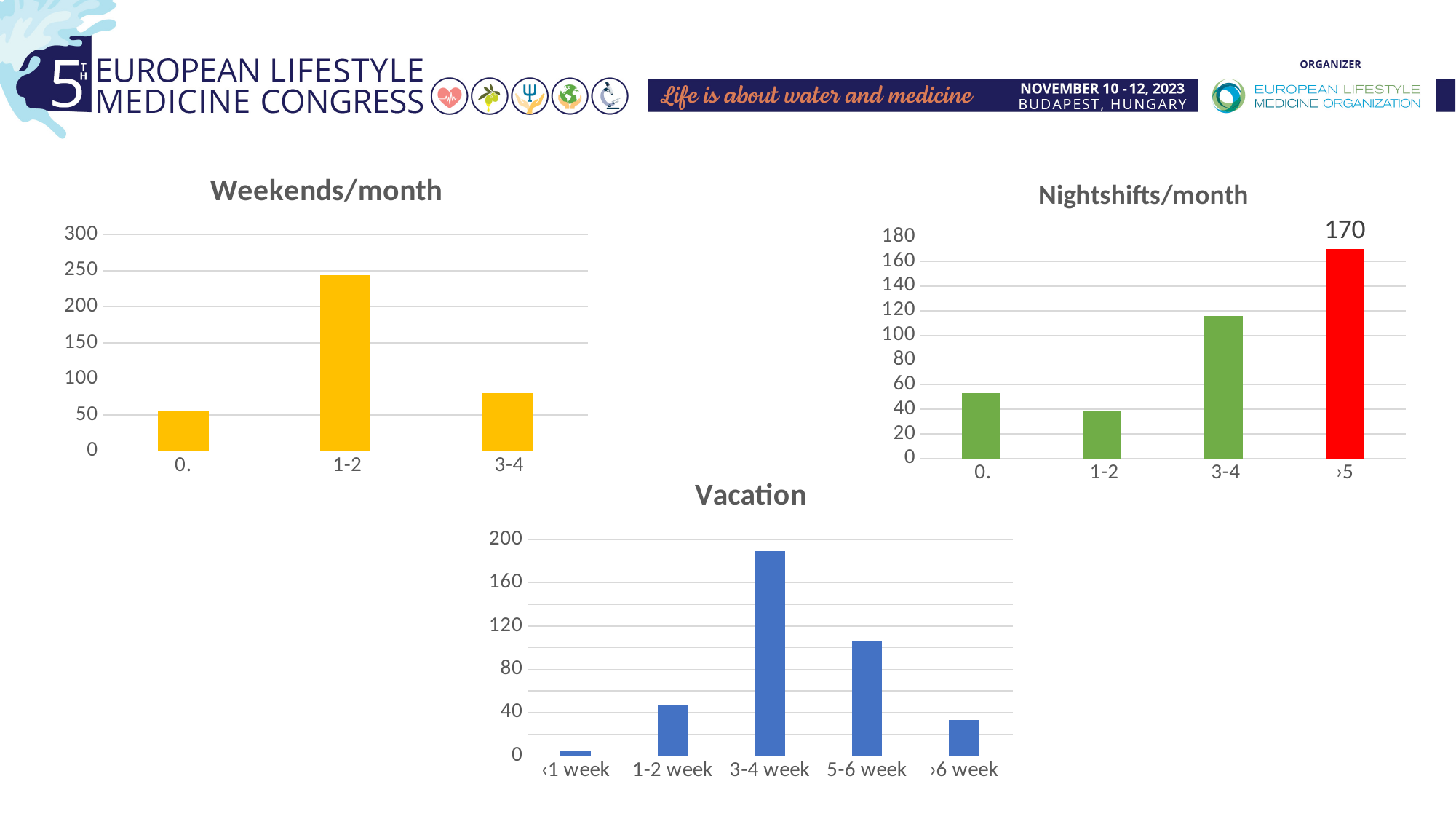
In the Vacation chart, which category has the lowest bar? <1 week In the Vacation chart, is the value for '5-6 week' greater or less than 80? greater In the Weekends/month chart, which category has the highest bar? 1-2 In the Nightshifts/month chart, what value is shown for the '>5' category? 170 In the Nightshifts/month chart, which category has the lowest value? 1-2 How many categories are shown in the Vacation chart? 5 In the Nightshifts/month chart, which category has the highest value? >5 In the Nightshifts/month chart, what colour is the bar for the '>5' category? Red In the Vacation chart, which category has the highest bar? 3-4 week How many categories are shown in the Weekends/month chart? 3 In the Weekends/month chart, which category has the lowest bar? 0. In the Weekends/month chart, is the value for '1-2' greater or less than 200? greater